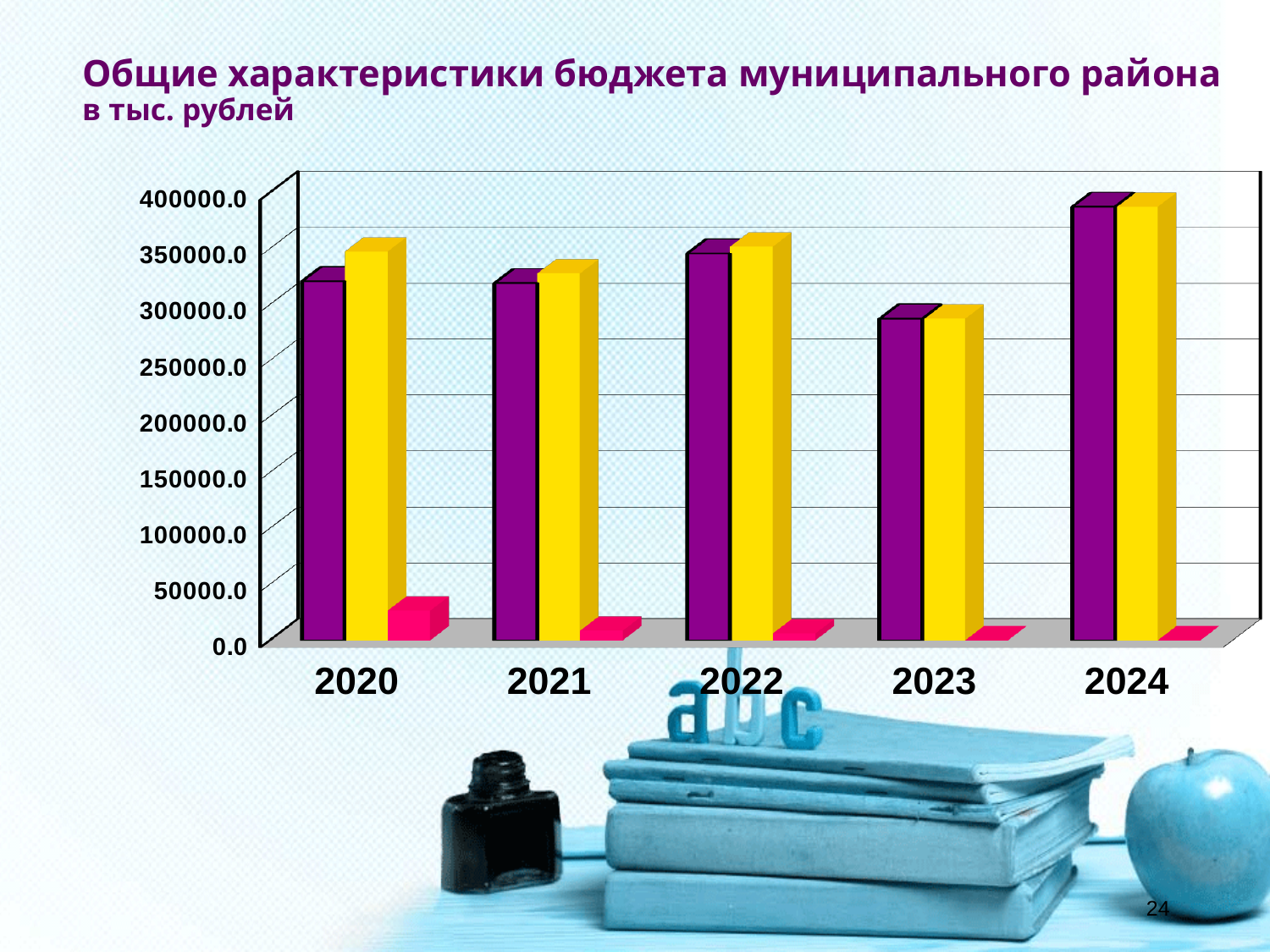
For 2020, which is larger: the purple bar or the yellow bar? the yellow bar Is the value of the pink bar for 2020 greater or less than 50000.0? less Is the value of the purple bar for 2024 greater or less than 350000.0? greater How many bars (series) are plotted for each year? 3 Is the value of the yellow bar for 2023 greater or less than 300000.0? less In which year is the yellow bar the tallest? 2024 In which year is the purple bar the tallest? 2024 Does the purple bar rise or fall from 2023 to 2024? rise What kind of chart is shown on the slide? bar chart In which year is the pink bar the tallest? 2020 How many years are shown on the x axis of the chart? 5 In which year is the purple bar the shortest? 2023